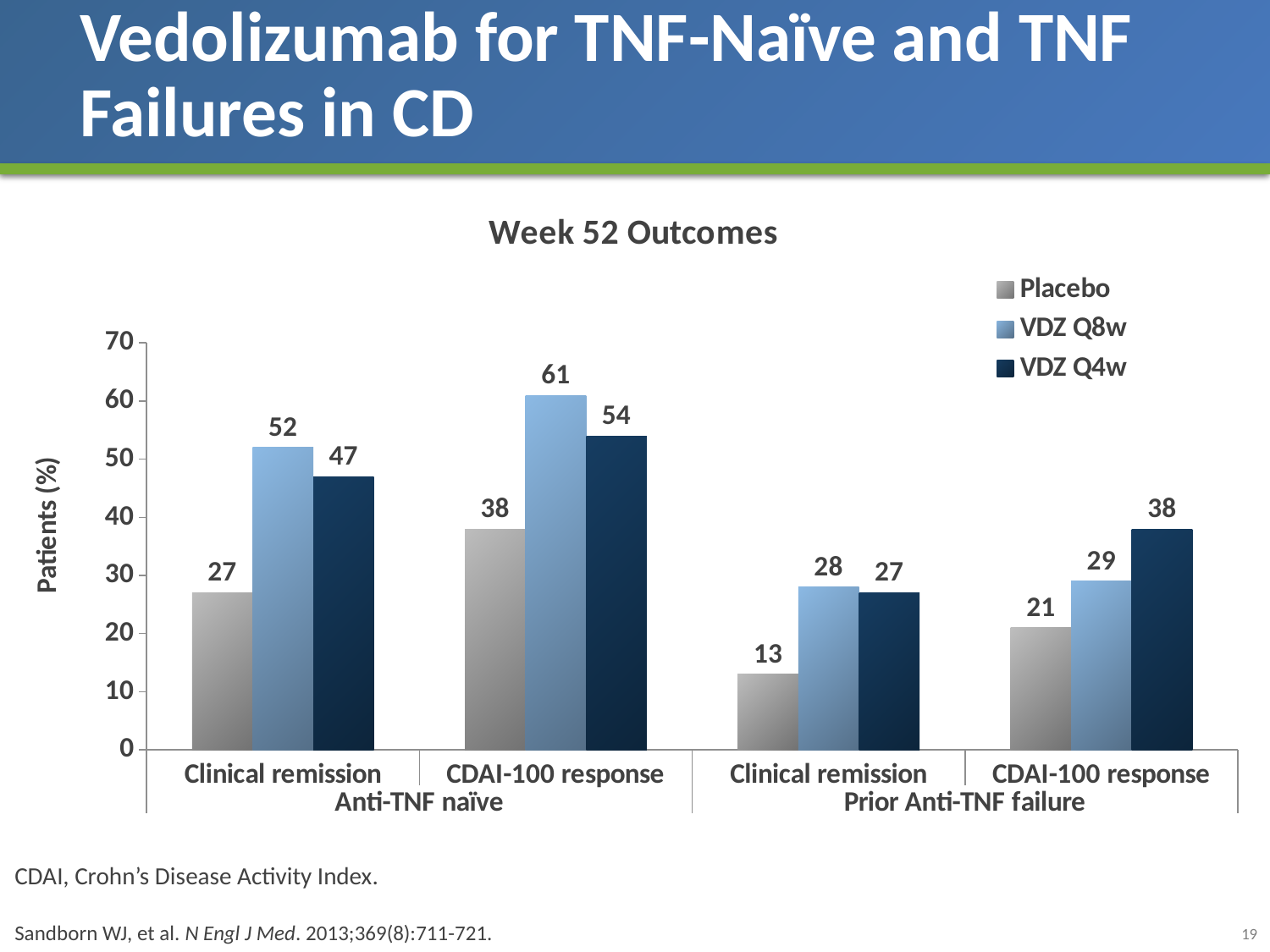
What is the VDZ Q8w value for CDAI-100 response in the Anti-TNF naïve group? 61 What is the title of the chart? Week 52 Outcomes Which series has the lowest value for CDAI-100 response in the Prior Anti-TNF failure group? Placebo What kind of chart is shown on the slide? bar chart Is the Placebo value for CDAI-100 response in the Anti-TNF naïve group greater or less than 30? greater What is the Placebo value for Clinical remission in the Prior Anti-TNF failure group? 13 What is the VDZ Q4w value for CDAI-100 response in the Prior Anti-TNF failure group? 38 Which is larger: the VDZ Q4w value for CDAI-100 response in the Anti-TNF naïve group or the VDZ Q4w value for CDAI-100 response in the Prior Anti-TNF failure group? Anti-TNF naïve What is the label of the y axis? Patients (%) How many series does the legend list? 3 What is the difference between the VDZ Q8w and Placebo values for Clinical remission in the Anti-TNF naïve group? 25 Which series has the highest value for Clinical remission in the Anti-TNF naïve group? VDZ Q8w